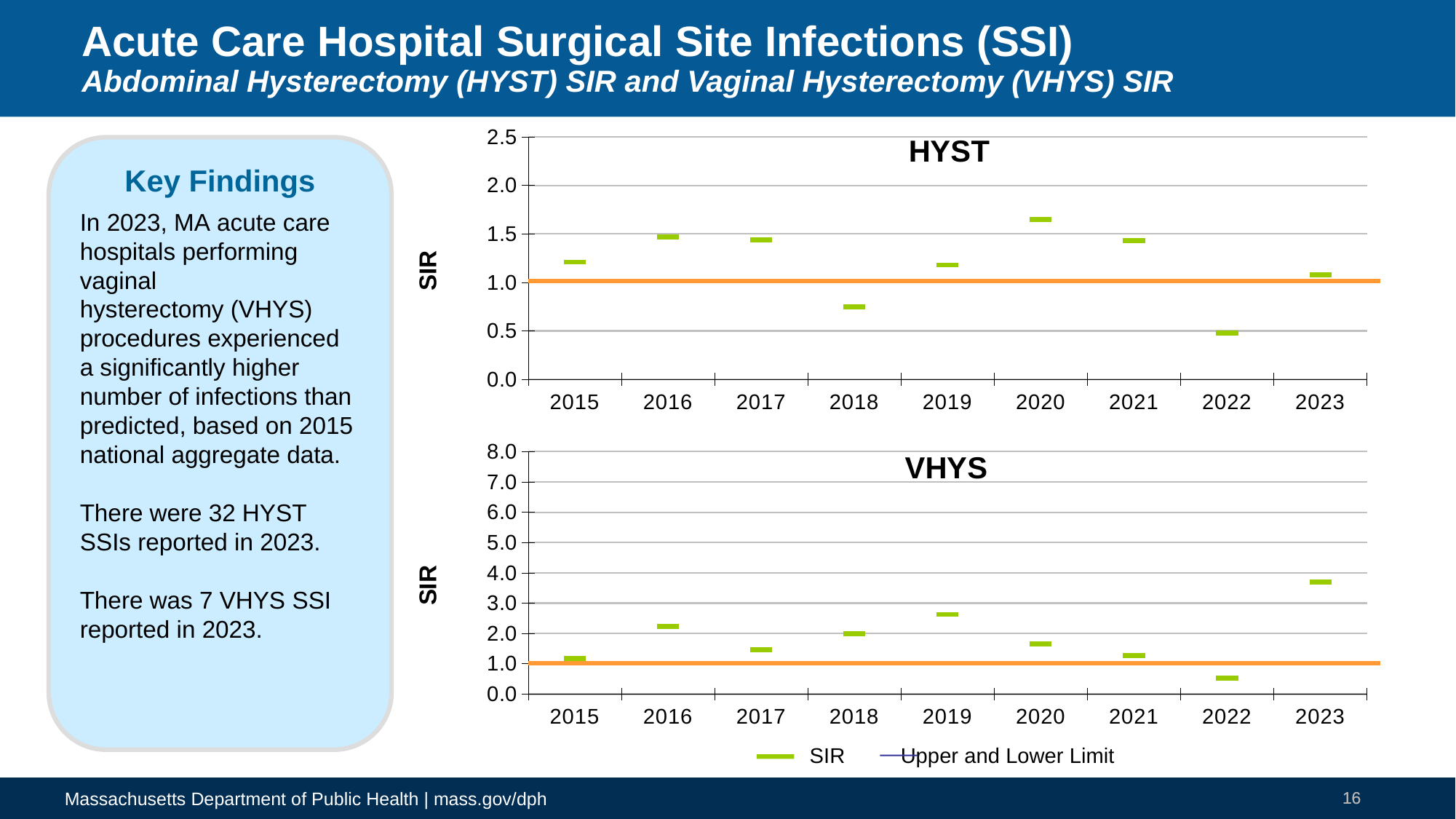
In the VHYS chart, which year has the highest SIR? 2023 In the VHYS chart, is the SIR larger in 2023 or in 2015? 2023 In the HYST chart, which year has the lowest SIR? 2022 In the HYST chart, is the SIR for 2020 greater or less than 1.5? greater In the VHYS chart, is the SIR for 2022 greater or less than 1.0? less In the HYST chart, is the SIR for 2018 greater or less than 1.0? less In the HYST chart, which year has the highest SIR? 2020 How many years are plotted on the x axis of the HYST chart? 9 In the HYST chart, is the SIR larger in 2020 or in 2022? 2020 How many entries does the legend below the VHYS chart list? 2 In the VHYS chart, which year has the lowest SIR? 2022